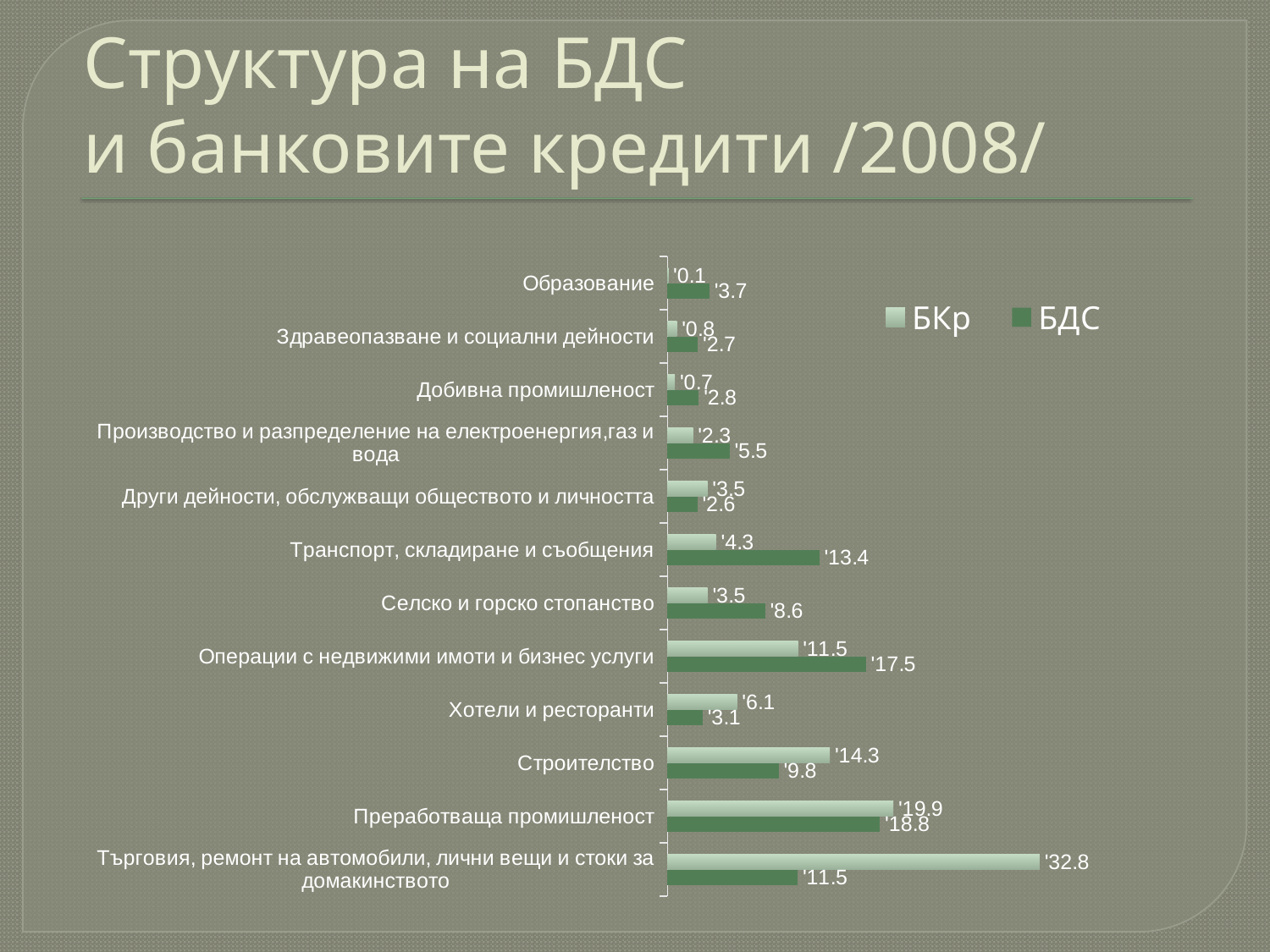
Which category has the highest БДС value? Преработваща промишленост What type of chart is shown on the slide? bar chart How many categories are shown on the chart? 12 What is the difference between the БКр and БДС values for Търговия, ремонт на автомобили, лични вещи и стоки за домакинството? 21.3 Which category has the highest БКр value? Търговия, ремонт на автомобили, лични вещи и стоки за домакинството What is the БКр value for Образование? 0.1 What are the two series names shown in the legend? БКр and БДС What is the БДС value for Транспорт, складиране и съобщения? 13.4 What is the БКр value for Търговия, ремонт на автомобили, лични вещи и стоки за домакинството? 32.8 For Строителство, which is larger: the БКр value or the БДС value? БКр Which category has the lowest БКр value? Образование How many series does the legend list? 2